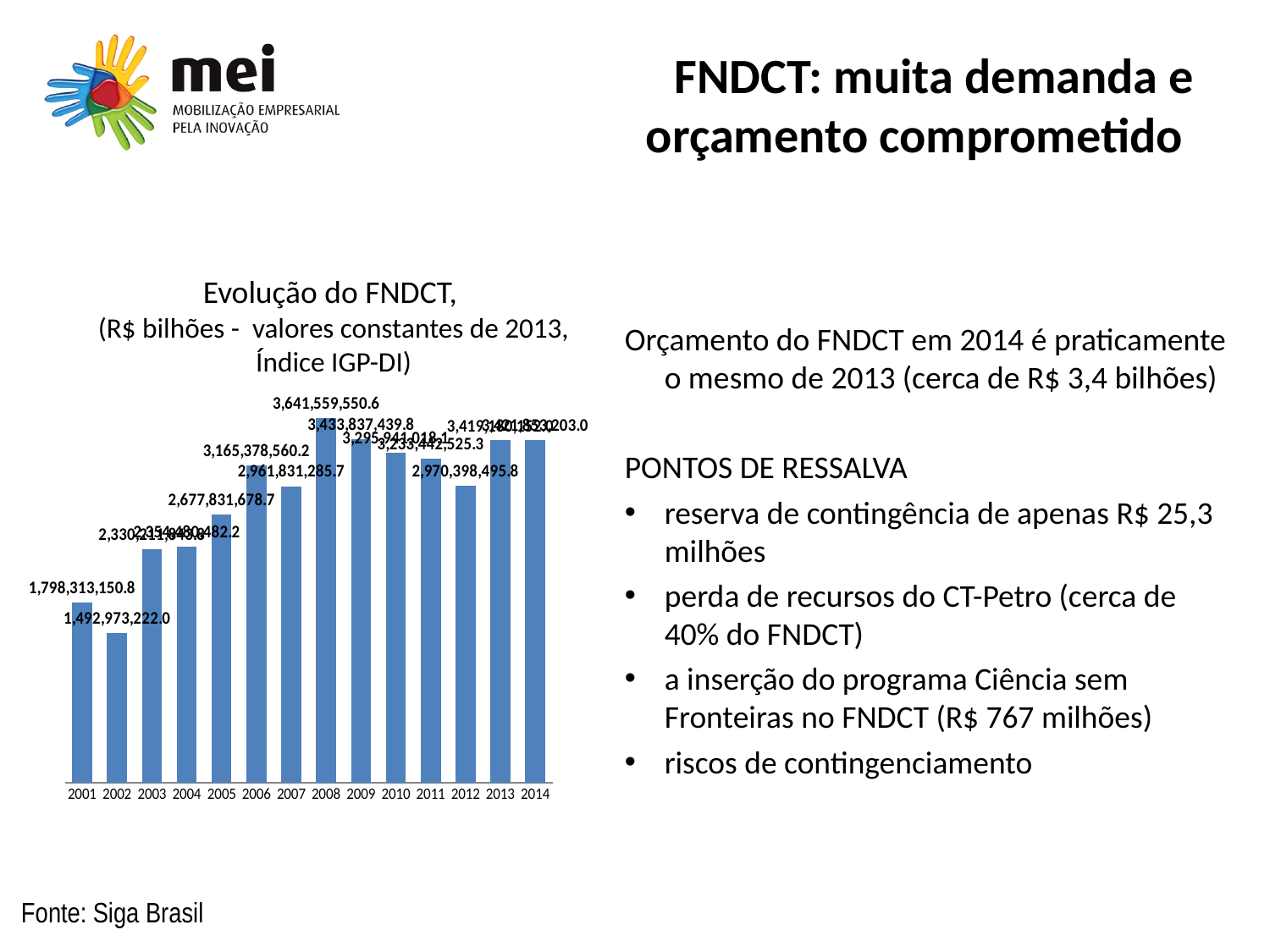
What is the value for 2005 in the chart? 2,677,831,678.7 Which year has the highest value in the chart? 2008 Which year has the lowest value in the chart? 2002 What is the value for 2012 in the chart? 2,970,398,495.8 What is the value for 2008 in the chart? 3,641,559,550.6 What is the difference between the values for 2008 and 2009? 207,722,110.8 What is the title of the chart? Evolução do FNDCT, (R$ bilhões - valores constantes de 2013, Índice IGP-DI) Which is larger, the value for 2007 or the value for 2012? 2012 What is the value for 2002 in the chart? 1,492,973,222.0 How many years are shown on the x axis of the chart? 14 What type of chart is shown on the slide? bar chart From 2008 to 2012, do the values rise or fall? fall